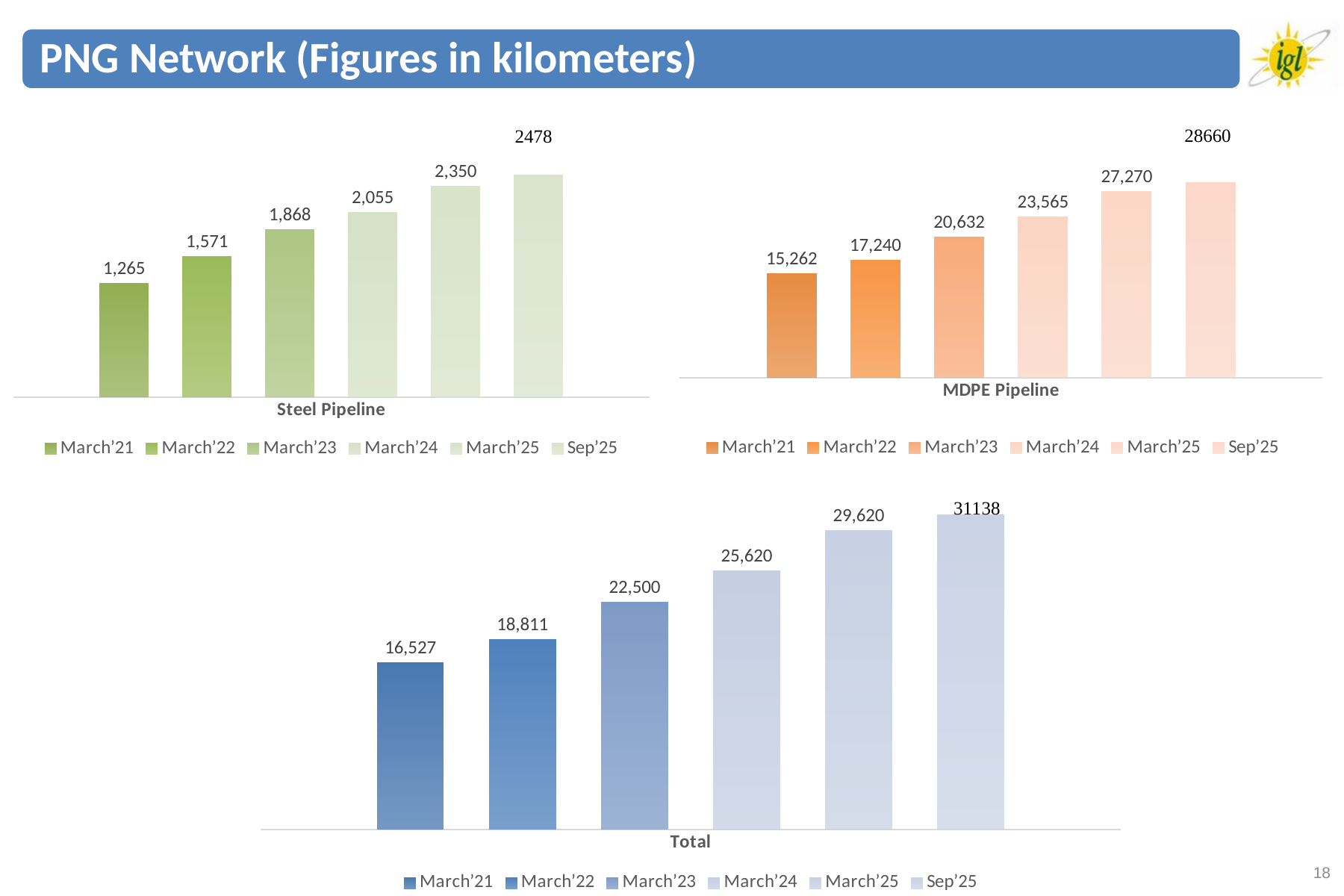
In the Total chart, what is the value for March'23? 22,500 In the Steel Pipeline chart, what is the value for Sep'25? 2478 In the Total chart, which period has the lowest value? March'21 In the MDPE Pipeline chart, do the values rise or fall from March'21 to Sep'25? Rise In the Steel Pipeline chart, what is the difference between the March'25 and March'24 values? 295 How many bars are shown in the Total chart? 6 In the MDPE Pipeline chart, which period has the highest value? Sep'25 In the MDPE Pipeline chart, what is the value for March'24? 23,565 In the MDPE Pipeline chart, which is larger, the value for March'22 or March'23? March'23 In the Total chart, what is the difference between the Sep'25 and March'21 values? 14,611 In the Steel Pipeline chart, what is the value for March'21? 1,265 What type of chart is the Steel Pipeline chart? Bar chart